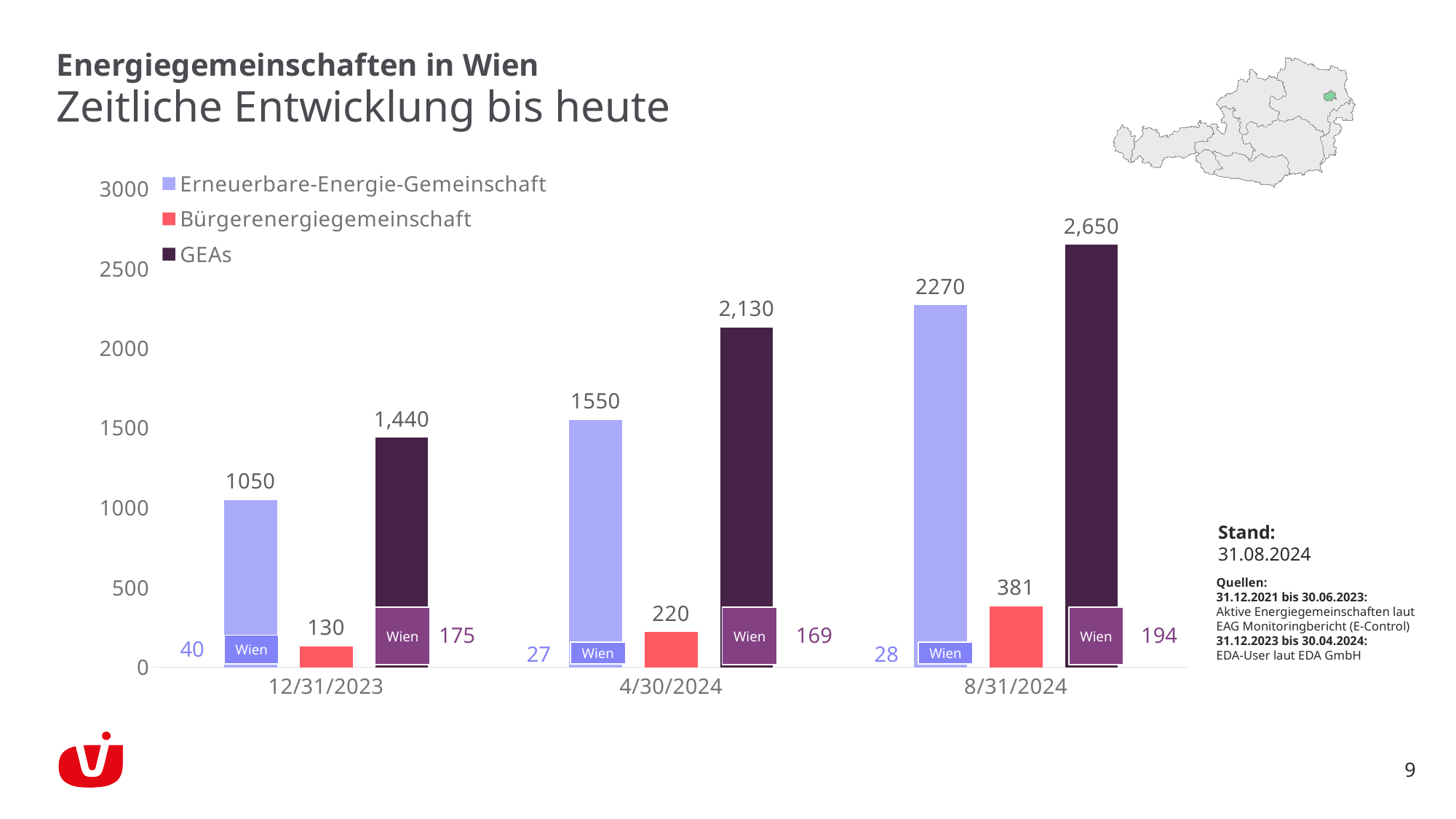
How many dates are shown on the x axis? 3 Which date has the highest value for Bürgerenergiegemeinschaft? 8/31/2024 What is the value for Bürgerenergiegemeinschaft on 8/31/2024? 381 What is the value for Erneuerbare-Energie-Gemeinschaft on 12/31/2023? 1050 What kind of chart is shown on the slide? Bar chart Which series has the lowest value on 4/30/2024? Bürgerenergiegemeinschaft What is the value for GEAs on 4/30/2024? 2,130 What is the value for GEAs on 8/31/2024? 2,650 How many series does the legend list? 3 Do the Erneuerbare-Energie-Gemeinschaft values rise or fall from 12/31/2023 to 8/31/2024? Rise Which is larger on 12/31/2023: Erneuerbare-Energie-Gemeinschaft or GEAs? GEAs What is the difference between the GEAs value and the Erneuerbare-Energie-Gemeinschaft value on 8/31/2024? 380